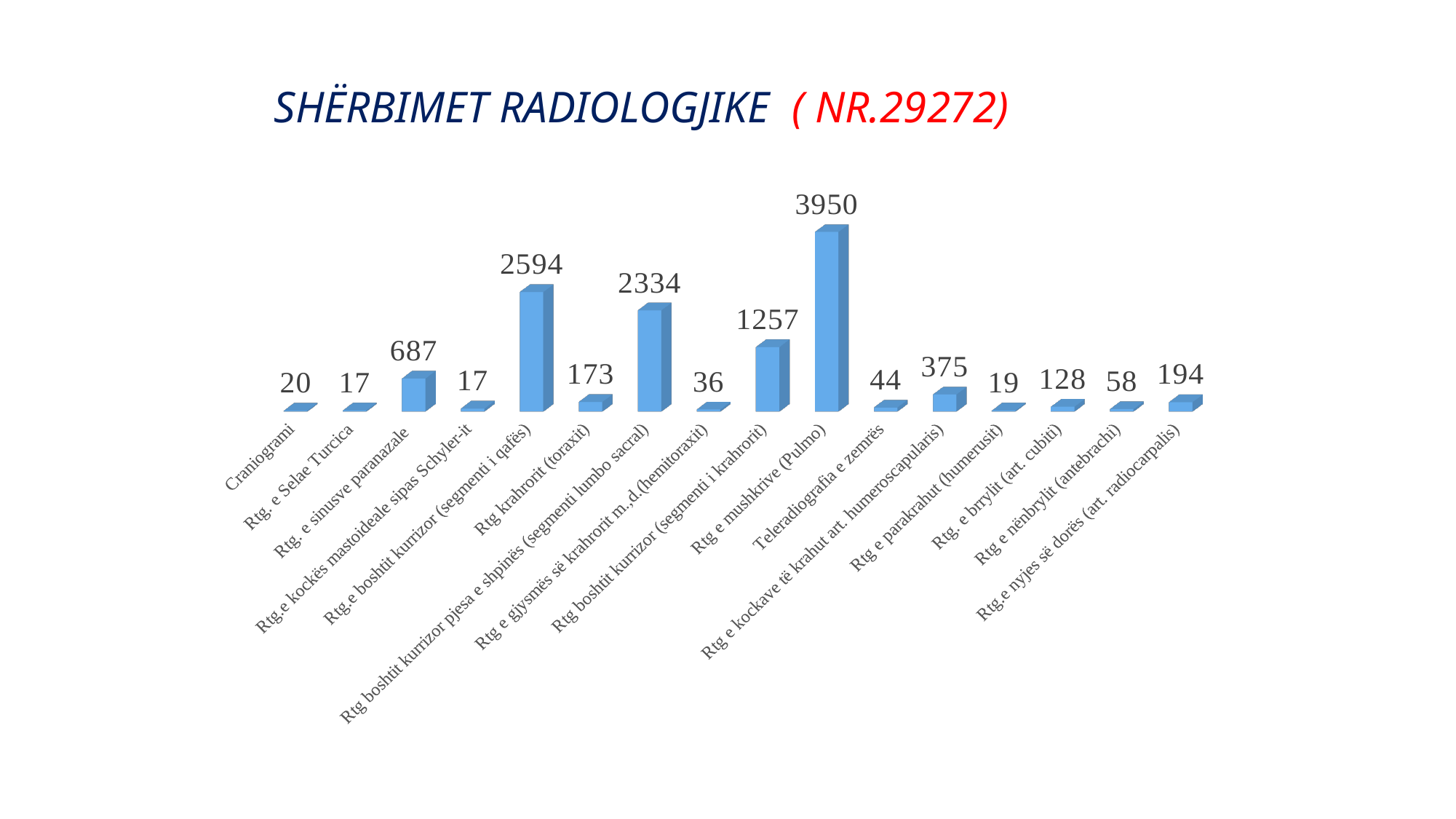
Which category has the highest value? Rtg e mushkrive (Pulmo) What is the title of the slide? SHËRBIMET RADIOLOGJIKE ( NR.29272) What is the value for Rtg. e sinusve paranazale? 687 What is the value for Craniogrami? 20 How many categories are shown in the chart? 16 Which is larger, the value for Rtg e kockave të krahut art. humeroscapularis or the value for Rtg. e brrylit (art. cubiti)? Rtg e kockave të krahut art. humeroscapularis What is the value for Rtg e nyjes së dorës (art. radiocarpalis)? 194 What is the difference between the values for Rtg.e boshtit kurrizor (segmenti i qafës) and Rtg boshtit kurrizor pjesa e shpinës (segmenti lumbo sacral)? 260 What is the difference between the values for Rtg e mushkrive (Pulmo) and Rtg boshtit kurrizor (segmenti i krahrorit)? 2693 What type of chart is shown on the slide? bar chart What is the value for Rtg e mushkrive (Pulmo)? 3950 What is the value for Teleradiografia e zemrës? 44